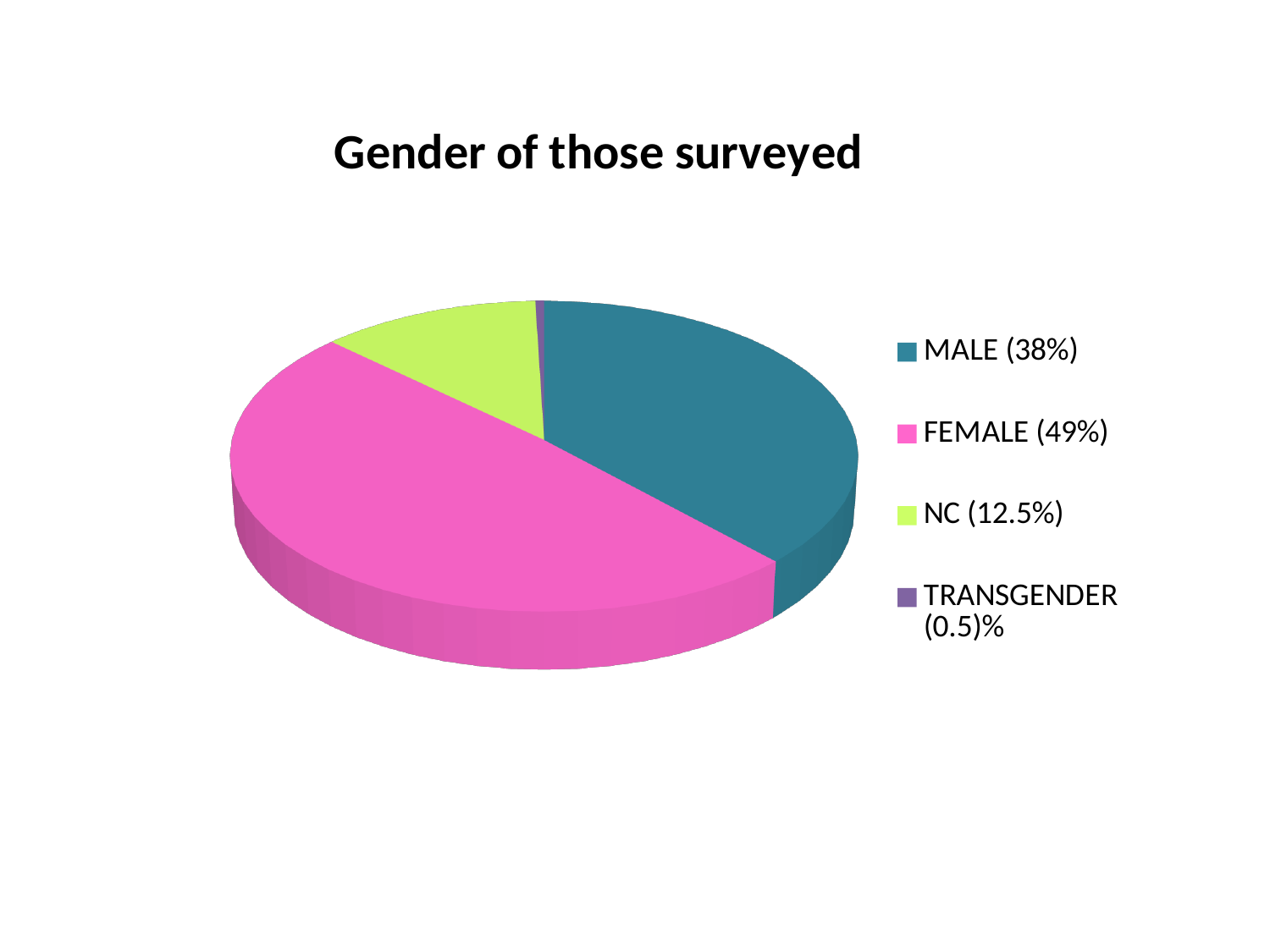
What kind of chart is shown on the slide? Pie chart What is the title of the chart? Gender of those surveyed What is the difference in percentage points between the female and male shares? 11 What percentage is shown for NC? 12.5% What percentage of those surveyed are female? 49% Which category has the largest share of the pie? FEMALE What percentage of those surveyed are male? 38% What percentage is shown for transgender? 0.5% What colour is the slice for FEMALE? Pink How many categories does the pie chart show? 4 Which is larger, the male share or the NC share? MALE Which category has the smallest share of the pie? TRANSGENDER